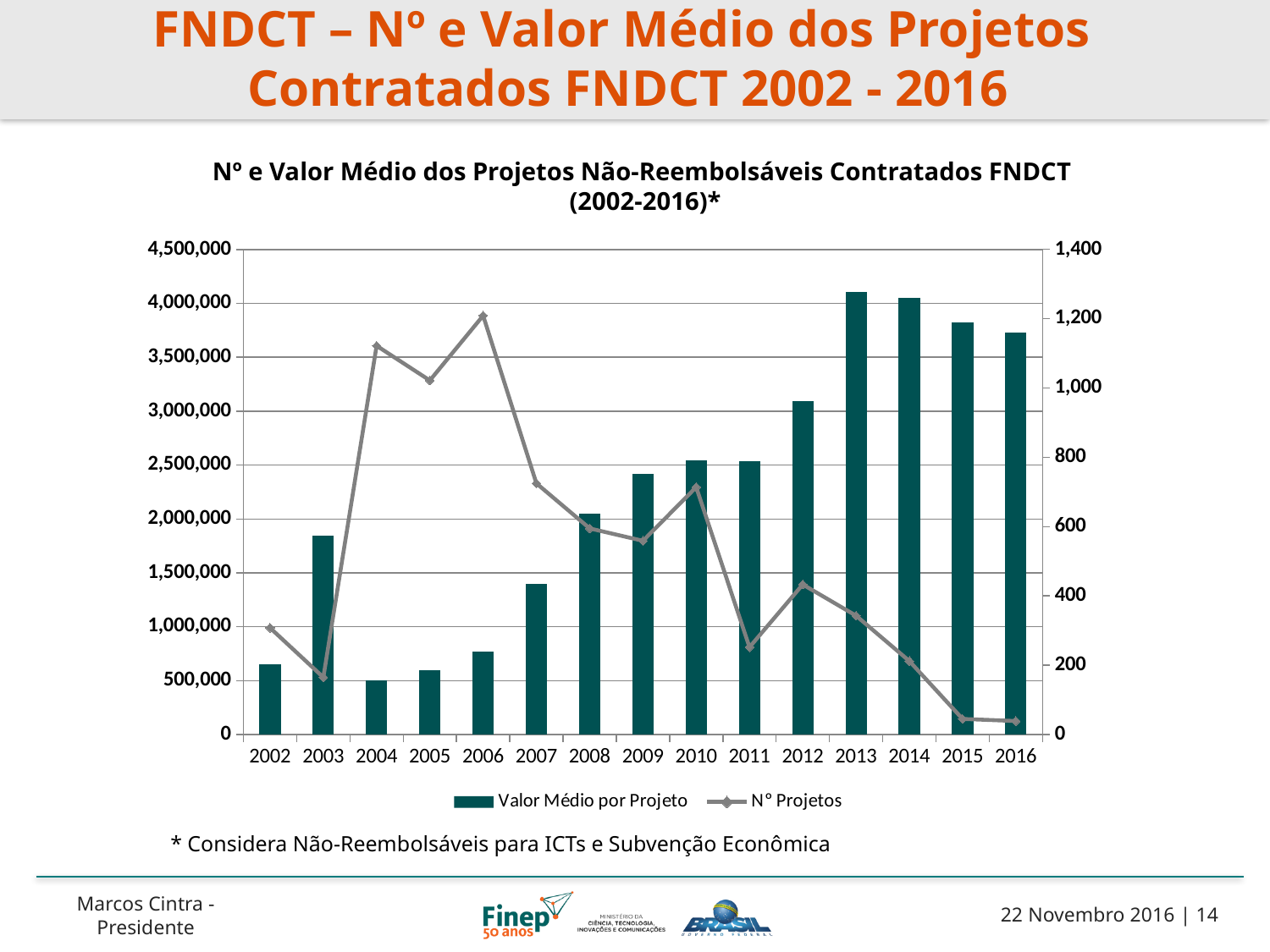
How many series does the legend list? 2 How many years are shown on the x axis? 15 In which year does the Nº Projetos line reach its highest point? 2006 Is the Valor Médio por Projeto bar for 2004 greater or less than 1,000,000? less Which year has the larger Valor Médio por Projeto bar, 2003 or 2007? 2003 Which year has the lowest bar for Valor Médio por Projeto? 2004 Does the Nº Projetos line rise or fall from 2012 to 2016? It falls Is the Valor Médio por Projeto bar for 2013 greater or less than 4,000,000? greater Which year has the highest bar for Valor Médio por Projeto? 2013 Is the Nº Projetos value for 2016 greater or less than 200? less What kind of chart is shown on the slide? A combined bar and line chart